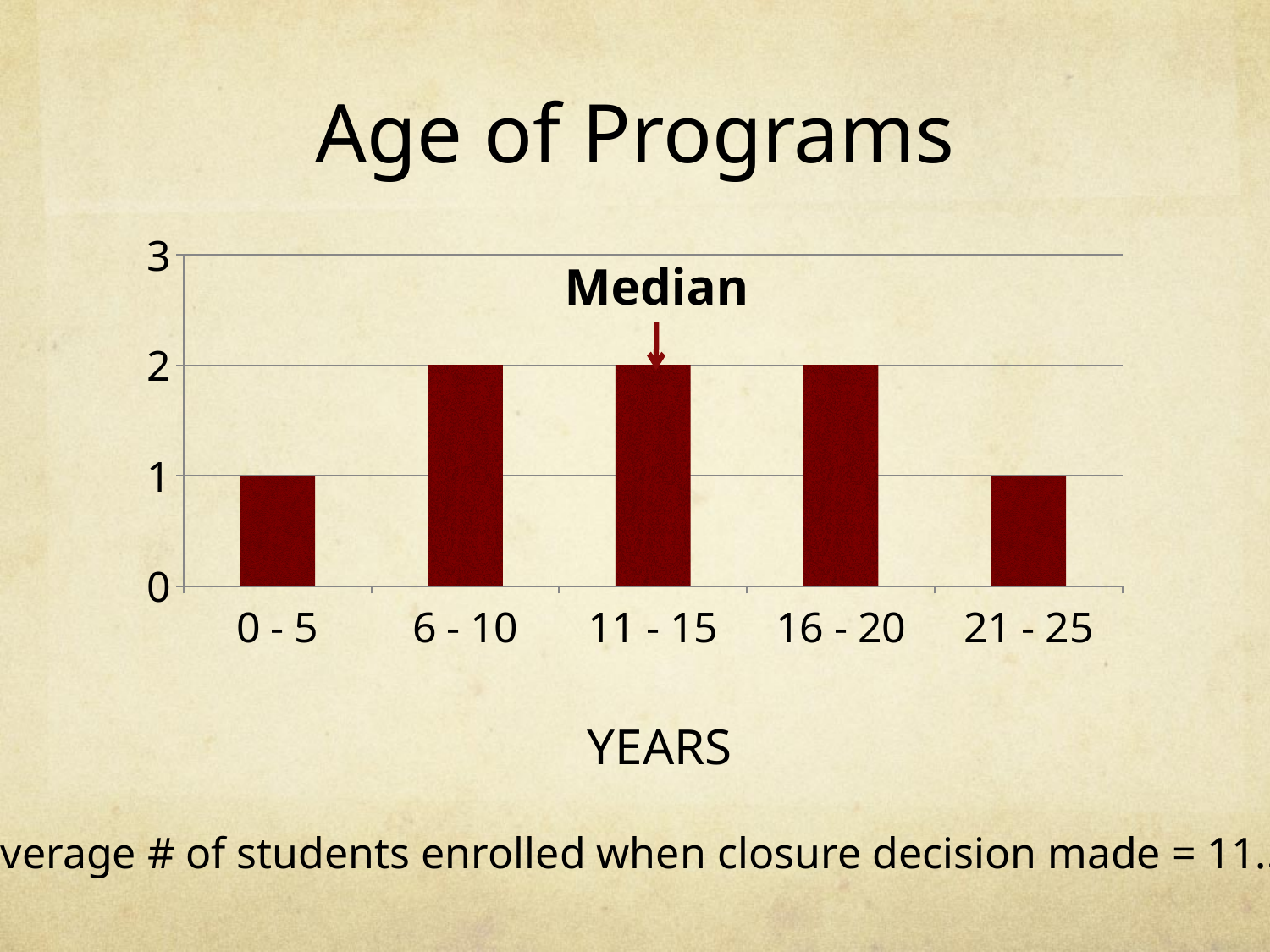
Which category does the "Median" arrow point to? 11 - 15 What is the title of the chart? Age of Programs What is the value for the 0 - 5 years category? 1 Is the value for 11 - 15 greater or less than 1? greater What is the value for the 11 - 15 years category? 2 What is the value for the 6 - 10 years category? 2 Which is larger, the value for 0 - 5 or the value for 6 - 10? 6 - 10 What is the value for the 16 - 20 years category? 2 What is the difference between the value for 16 - 20 and the value for 21 - 25? 1 What is the value for the 21 - 25 years category? 1 How many age categories are shown on the x axis? 5 What kind of chart is shown on the slide? bar chart